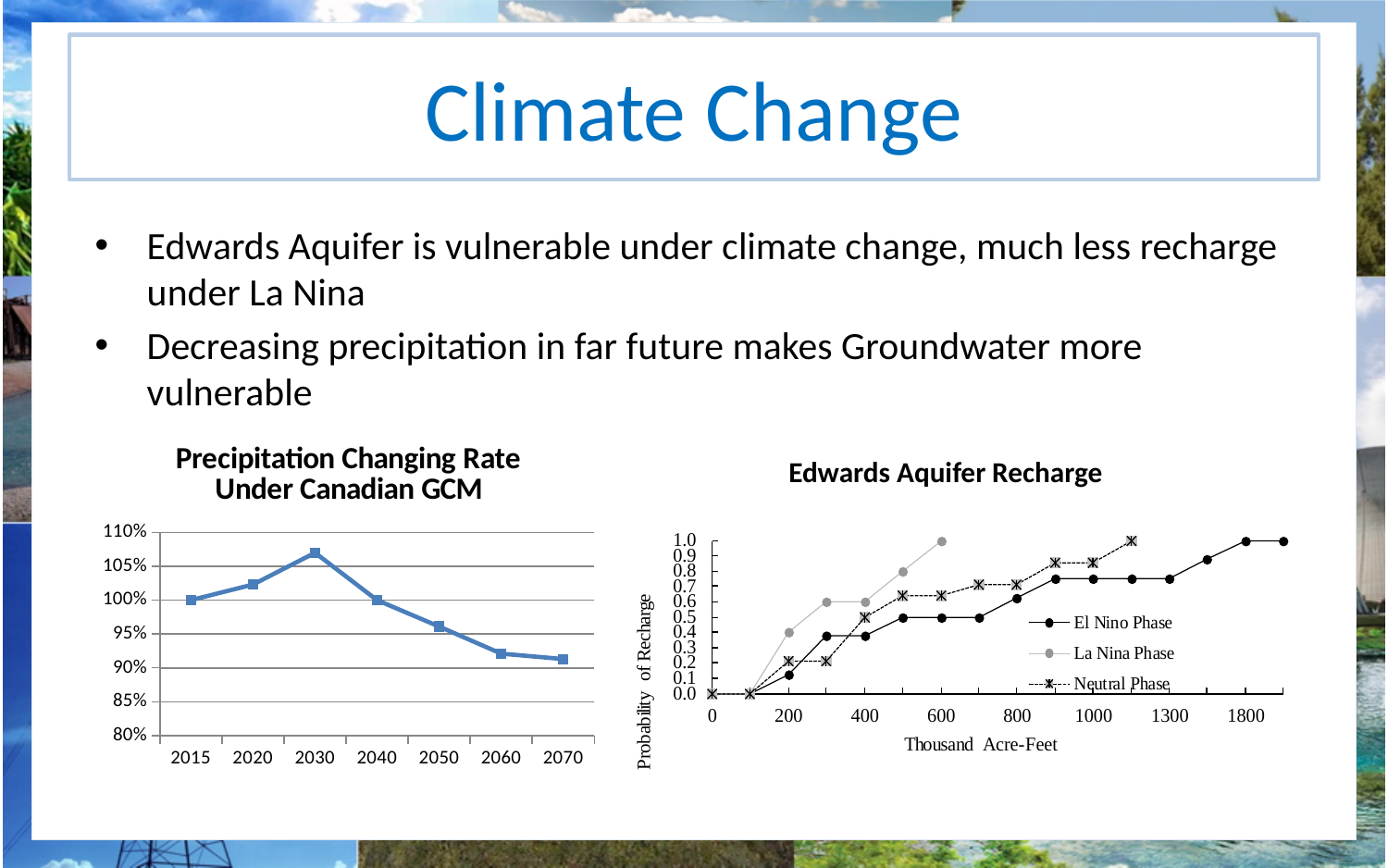
In the 'Precipitation Changing Rate Under Canadian GCM' chart, is the value for 2060 greater or less than 95%? less In the 'Precipitation Changing Rate Under Canadian GCM' chart, what is the value for 2015? 100% In the 'Precipitation Changing Rate Under Canadian GCM' chart, is the value for 2030 greater or less than 105%? greater In the 'Precipitation Changing Rate Under Canadian GCM' chart, which year has the highest precipitation changing rate? 2030 What are the legend entries in the 'Edwards Aquifer Recharge' chart? El Nino Phase, La Nina Phase, Neutral Phase What is the x-axis title of the 'Edwards Aquifer Recharge' chart? Thousand Acre-Feet What kind of chart is the 'Precipitation Changing Rate Under Canadian GCM' chart? line chart In the 'Precipitation Changing Rate Under Canadian GCM' chart, how many years are plotted on the x axis? 7 How many series does the legend of the 'Edwards Aquifer Recharge' chart list? 3 In the 'Precipitation Changing Rate Under Canadian GCM' chart, do the values rise or fall from 2030 to 2070? fall In the 'Precipitation Changing Rate Under Canadian GCM' chart, which is larger, the value for 2020 or the value for 2050? 2020 In the 'Edwards Aquifer Recharge' chart, which series has the highest probability of recharge at 600 thousand acre-feet? La Nina Phase